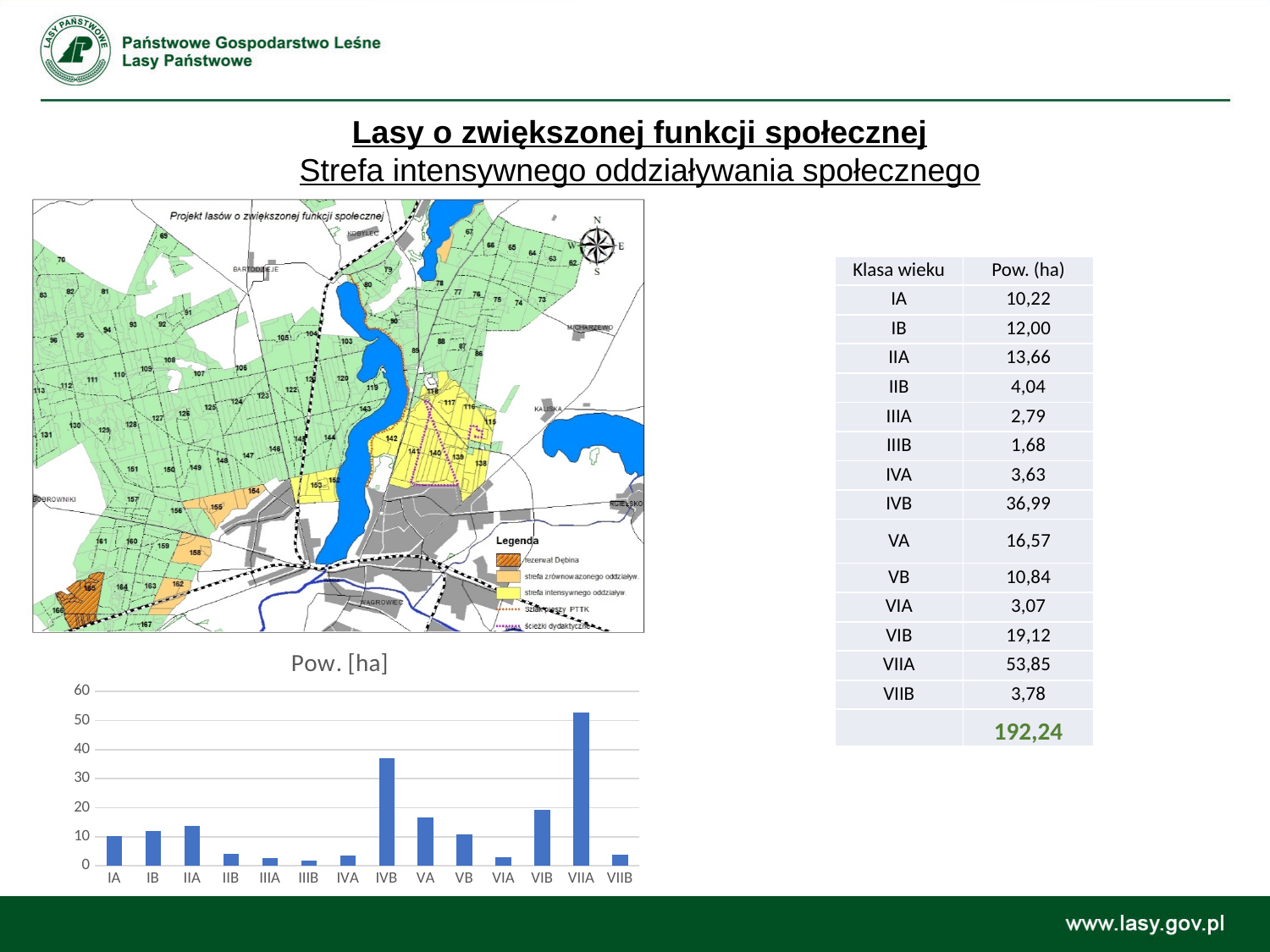
What is the title of the bar chart? Pow. [ha] Which is larger, the value for IIA or the value for IB? IIA What kind of chart is shown at the bottom left of the slide? bar chart What is the area (Pow.) for age class VIIA? 53,85 Which age class has the highest value in the bar chart? VIIA What is the area (Pow.) for age class IVB? 36,99 Is the value for VA greater or less than 20? less What is the difference between the values for VIIA and IVB? 16,86 How many age classes (categories) are plotted on the x axis of the bar chart? 14 Is the value for IVB greater or less than 30? greater Which is larger, the value for IVB or the value for VA? IVB What is the total area (Pow.) across all age classes? 192,24